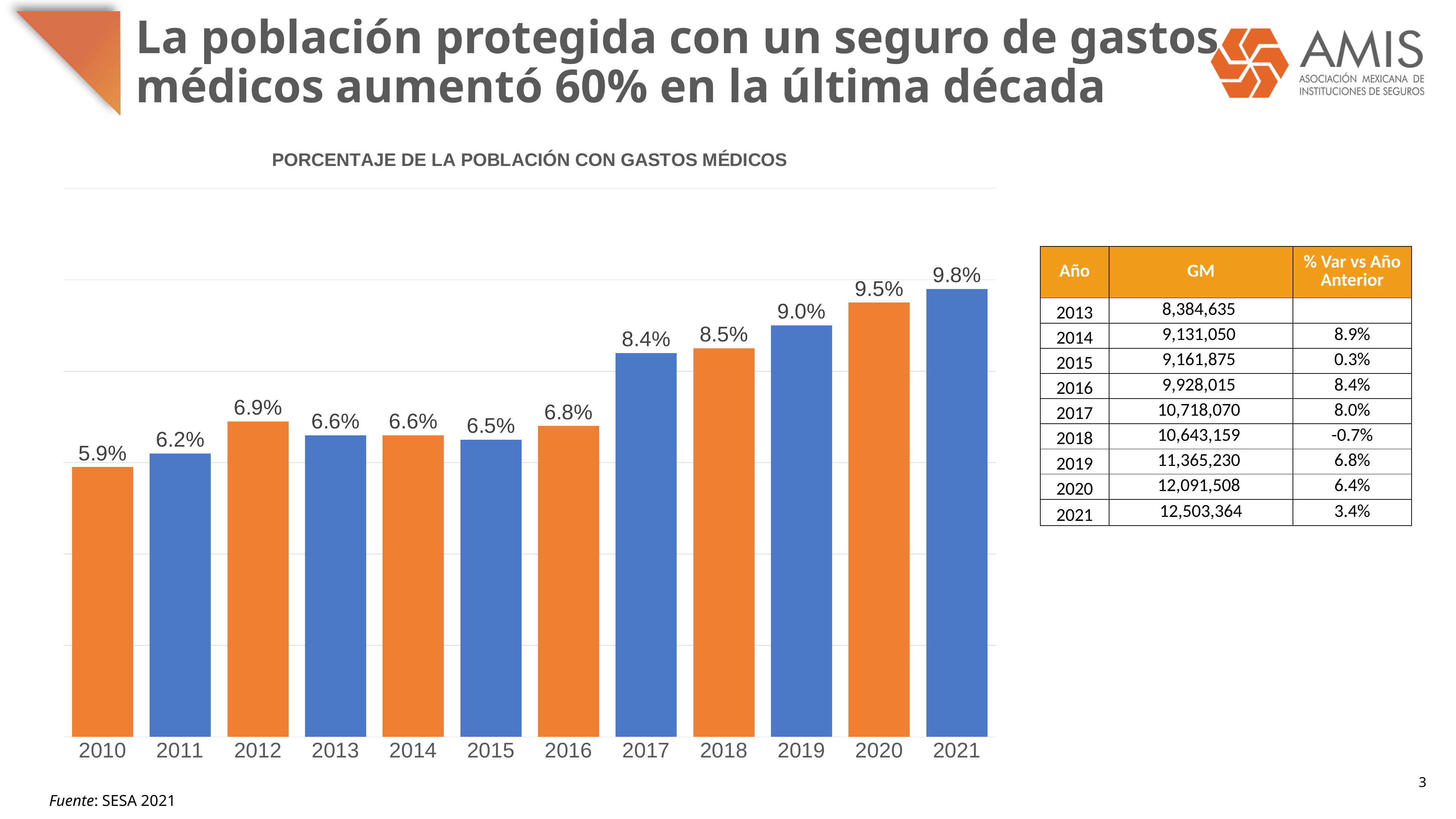
What is the difference between the values for 2021 and 2010? 3.9% What is the value for 2017 in the chart? 8.4% What is the difference between the values for 2019 and 2018? 0.5% Which is larger, the value for 2012 or the value for 2015? 2012 What is the value for 2010 in the chart? 5.9% What kind of chart is shown on the slide? Bar chart Which year has the lowest value in the chart? 2010 Do the values generally rise or fall from 2010 to 2021? Rise Which year has the highest value in the chart? 2021 What is the title of the chart? PORCENTAJE DE LA POBLACIÓN CON GASTOS MÉDICOS How many years are shown on the x axis of the chart? 12 What is the value for 2020 in the chart? 9.5%